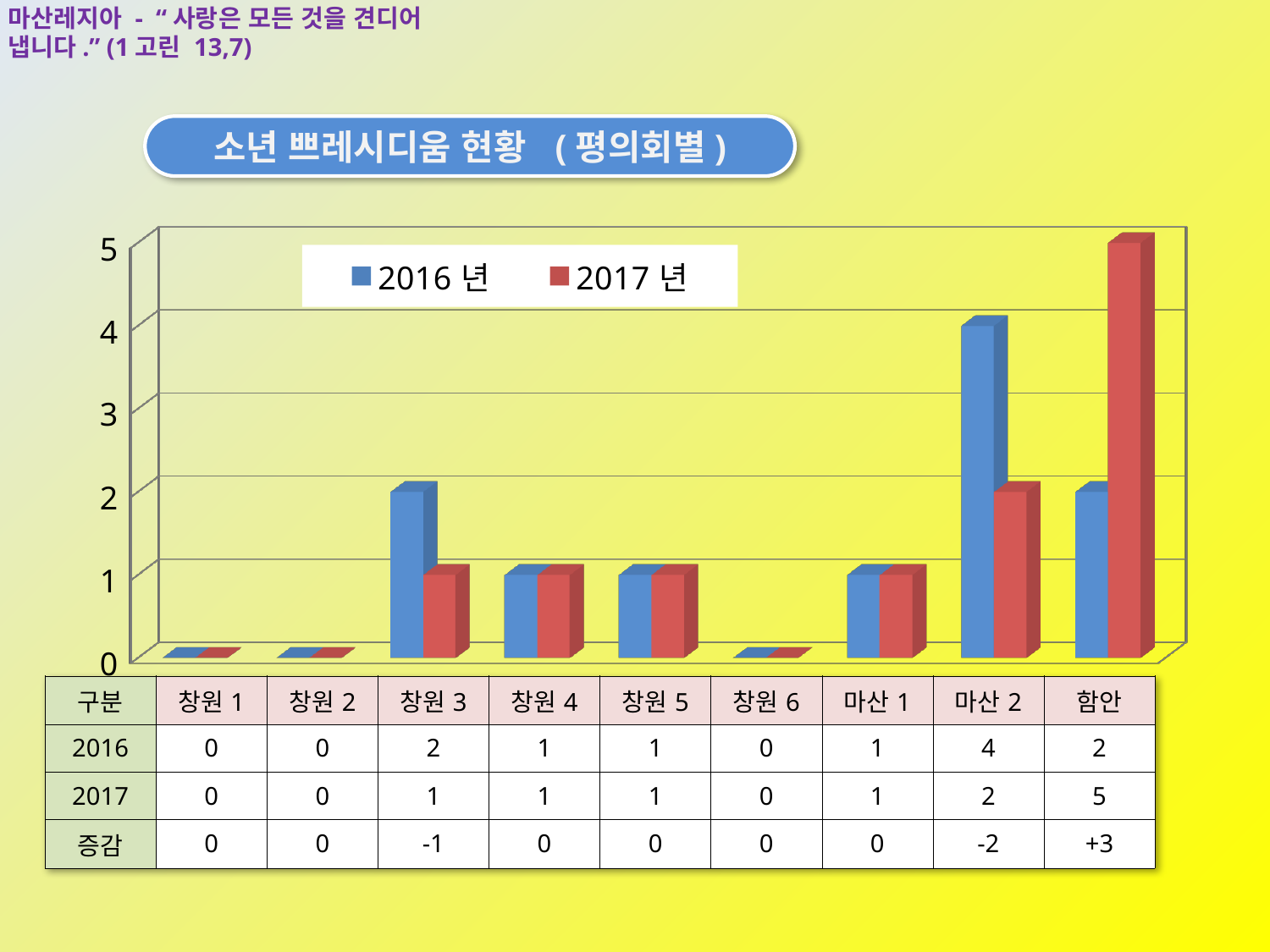
Which is larger for 마산 2: the 2016 년 value or the 2017 년 value? 2016 년 What is the value for 마산 2 in the 2016 년 series? 4 Which category has the highest value in the 2017 년 series? 함안 What is the value for 창원 3 in the 2017 년 series? 1 What is the difference between the 2017 년 and 2016 년 values for 함안? 3 How many series does the chart legend list? 2 What is the title of the chart on the slide? 소년 쁘레시디움 현황 (평의회별) What kind of chart is shown on the slide? bar chart What is the difference between the 2016 년 and 2017 년 values for 마산 2? 2 Which category has the highest value in the 2016 년 series? 마산 2 What is the value for 함안 in the 2017 년 series? 5 How many categories are shown along the x axis of the chart? 9